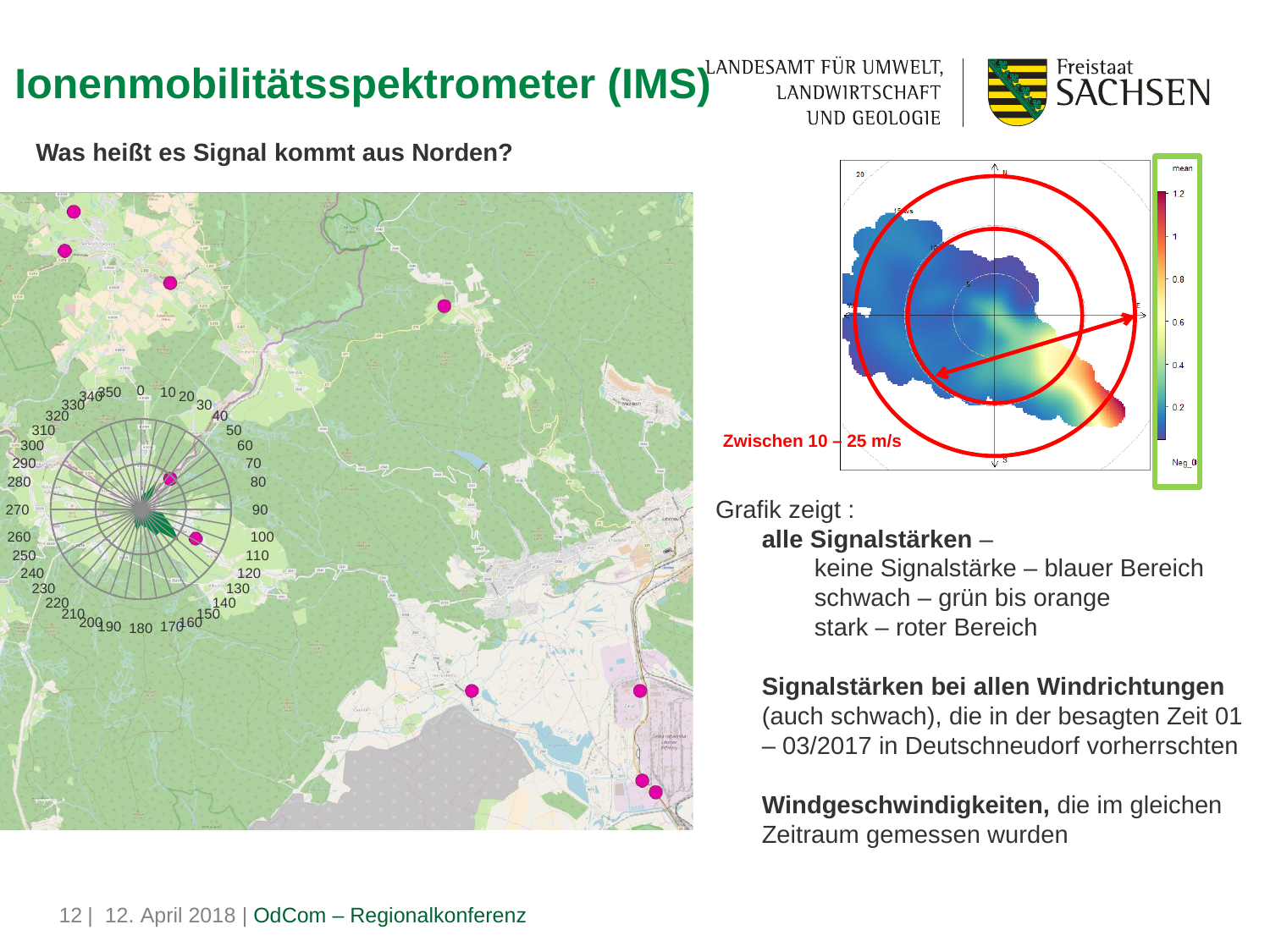
On the polar plot at the top right, what is the largest wind speed ring label shown? 20 How many degree labels are printed around the wind rose on the map (from 0 to 350 in steps of 10)? 36 On the polar plot at the top right, what is the lowest numeric value labelled on the colour bar? 0.2 On the polar plot at the top right, in which compass direction does the red/orange (strong signal) region lie? South-east On the polar plot at the top right, which colour represents no signal strength according to the slide text? Blue (blauer Bereich) On the polar plot at the top right, what is the title of the colour bar? mean On the polar plot at the top right, what wind speed range is highlighted by the red circles according to the red text? Zwischen 10 – 25 m/s What kind of chart is overlaid on the map on the left side of the slide? A wind rose (polar chart) On the polar plot at the top right, what is the highest value labelled on the colour bar? 1.2